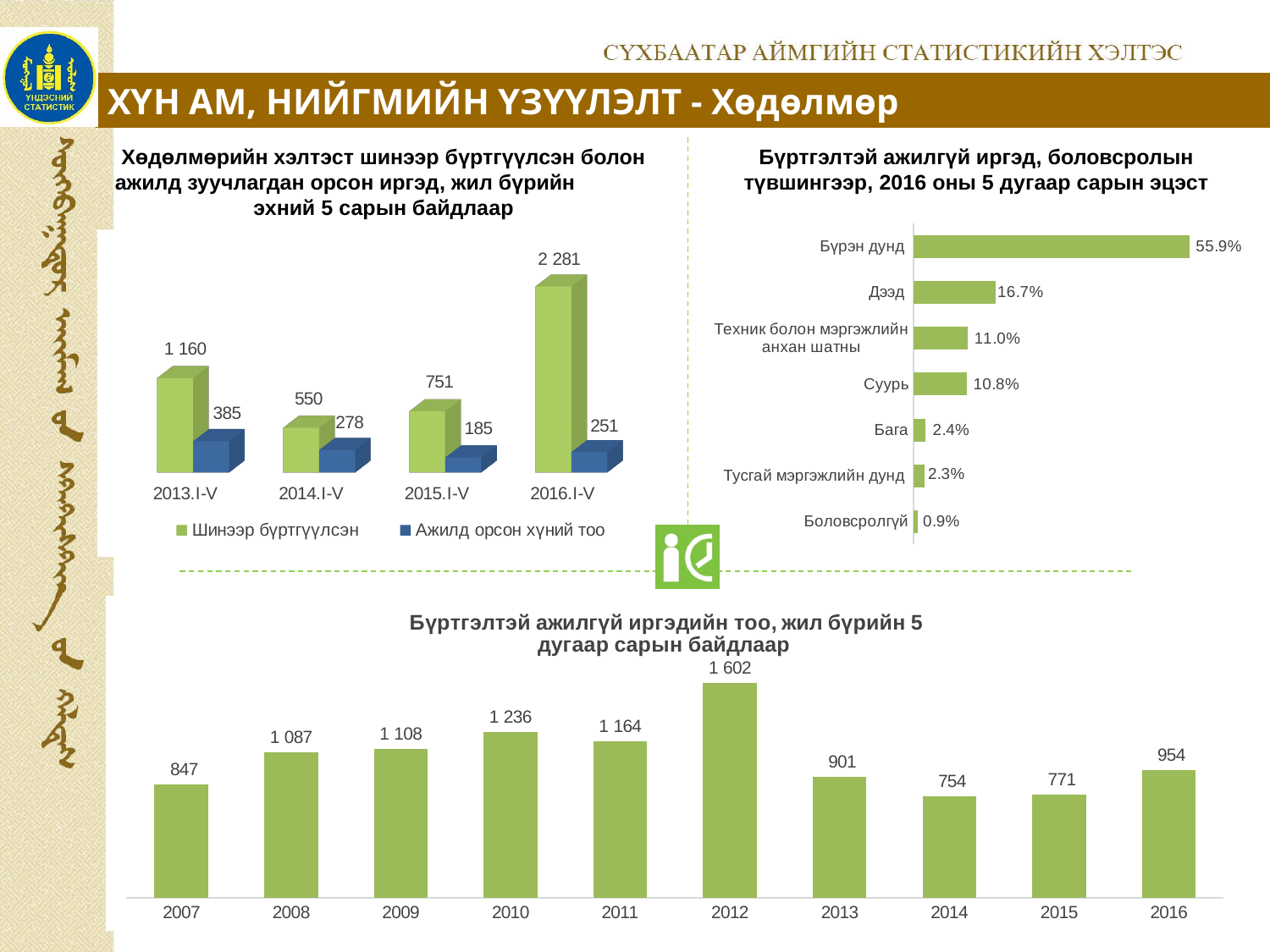
In the top-left chart (Хөдөлмөрийн хэлтэст шинээр бүртгүүлсэн...), what is the difference between Шинээр бүртгүүлсэн and Ажилд орсон хүний тоо in 2013.I-V? 775 In the top-right chart (Бүртгэлтэй ажилгүй иргэд, боловсролын түвшингээр...), which category has the highest value? Бүрэн дунд In the top-left chart (Хөдөлмөрийн хэлтэст шинээр бүртгүүлсэн...), what is the value for Ажилд орсон хүний тоо in 2015.I-V? 185 In the top-right chart (Бүртгэлтэй ажилгүй иргэд, боловсролын түвшингээр...), which category has the lowest value? Боловсролгүй In the bottom chart (Бүртгэлтэй ажилгүй иргэдийн тоо...), what is the value for 2012? 1 602 In the top-right chart (Бүртгэлтэй ажилгүй иргэд, боловсролын түвшингээр...), how many categories are shown? 7 In the top-right chart (Бүртгэлтэй ажилгүй иргэд, боловсролын түвшингээр...), what is the value for Суурь? 10.8% In the bottom chart (Бүртгэлтэй ажилгүй иргэдийн тоо...), which year has the lowest value? 2014 In the top-left chart (Хөдөлмөрийн хэлтэст шинээр бүртгүүлсэн...), what is the value for Шинээр бүртгүүлсэн in 2016.I-V? 2 281 In the bottom chart (Бүртгэлтэй ажилгүй иргэдийн тоо...), which is larger, the value for 2010 or the value for 2011? 2010 In the top-left chart (Хөдөлмөрийн хэлтэст шинээр бүртгүүлсэн...), how many series does the legend list? 2 What kind of chart is the bottom chart (Бүртгэлтэй ажилгүй иргэдийн тоо...)? Bar chart